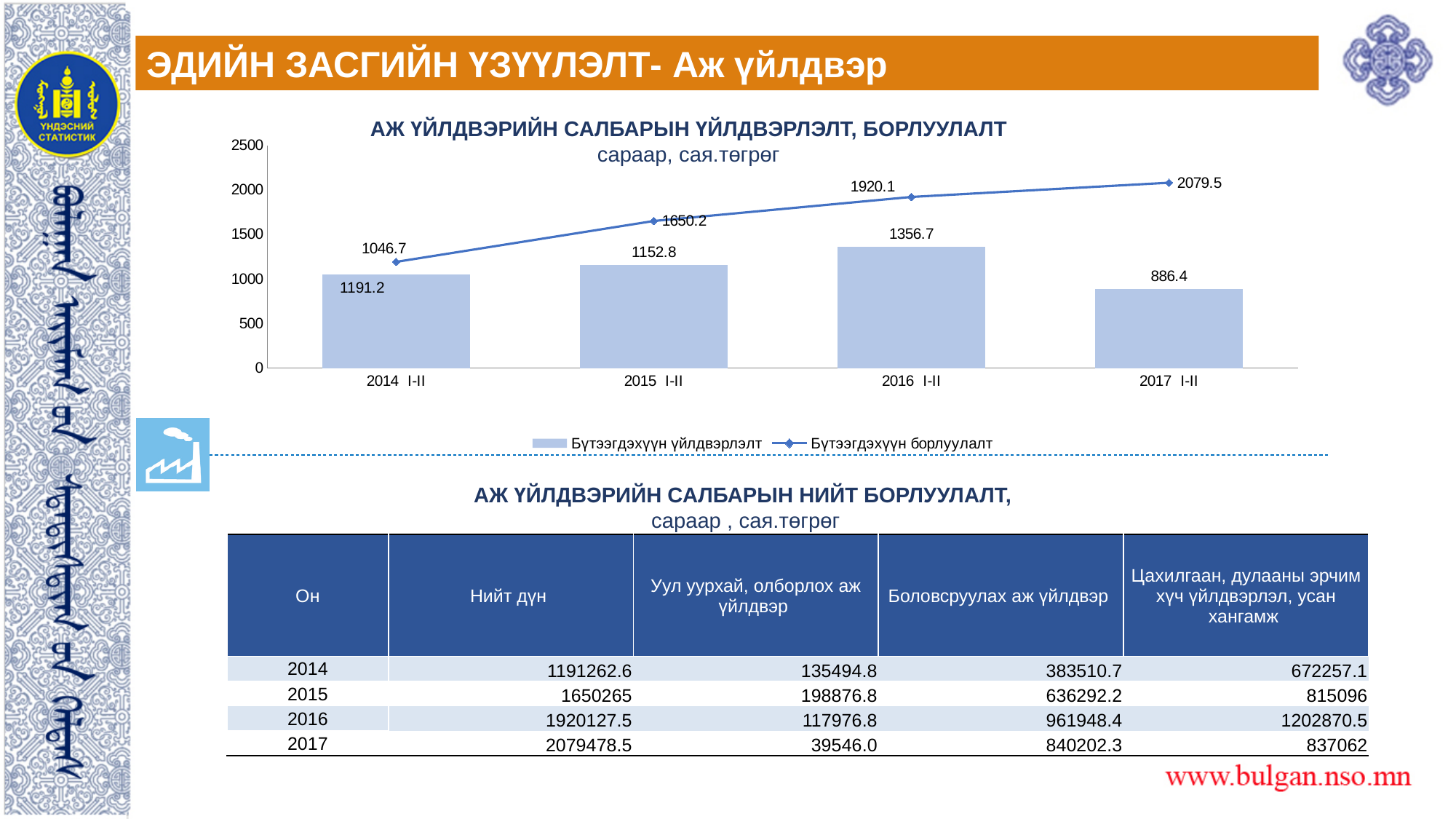
In the chart 'АЖ ҮЙЛДВЭРИЙН САЛБАРЫН ҮЙЛДВЭРЛЭЛТ, БОРЛУУЛАЛТ', what is the value of the bar (Бүтээгдэхүүн үйлдвэрлэлт) for 2016 I-II? 1356.7 In the chart, for 2016 I-II, which is larger: the bar value (Бүтээгдэхүүн үйлдвэрлэлт) or the line value (Бүтээгдэхүүн борлуулалт)? Бүтээгдэхүүн борлуулалт (line) In the chart, what is the difference between the line values for 2017 I-II and 2016 I-II? 159.4 How many series does the chart's legend list? 2 How many periods are shown on the x axis of the chart? 4 In the chart, which period has the lowest bar (Бүтээгдэхүүн үйлдвэрлэлт)? 2017 I-II In the chart, is the bar value for 2015 I-II greater or less than 1000? greater In the chart, what is the value of the line (Бүтээгдэхүүн борлуулалт) for 2015 I-II? 1650.2 In the chart, which period has the highest bar (Бүтээгдэхүүн үйлдвэрлэлт)? 2016 I-II In the chart, what is the value of the line (Бүтээгдэхүүн борлуулалт) for 2017 I-II? 2079.5 In the chart, what is the difference between the bar values for 2016 I-II and 2015 I-II? 203.9 In the chart, what is the value of the bar for 2017 I-II? 886.4